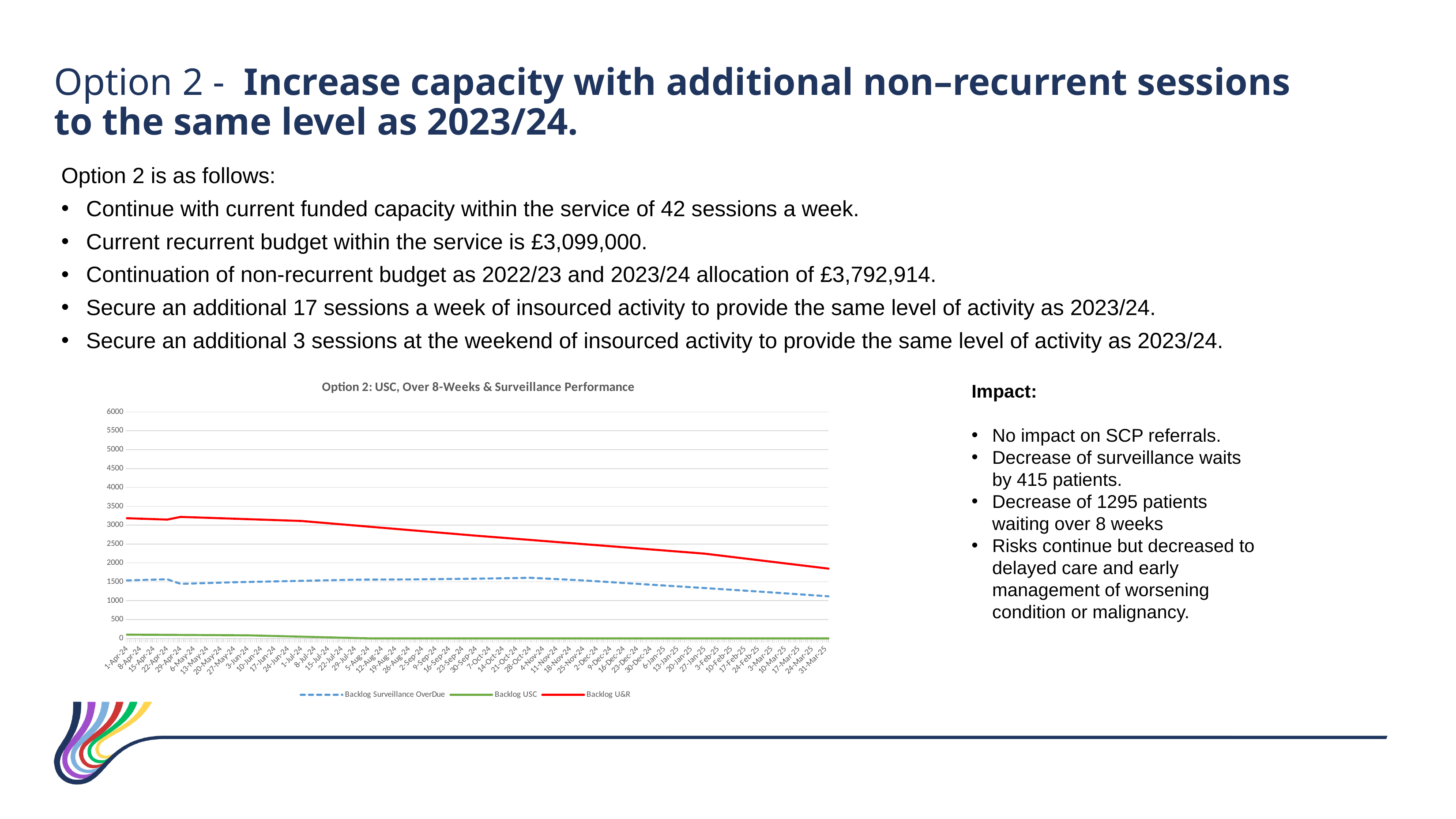
How many series does the chart legend list? 3 What kind of chart is shown on the slide? line chart Does the Backlog U&R line rise or fall from 1-Apr-24 to 31-Mar-25? fall At 31-Mar-25, which is larger: Backlog U&R or Backlog Surveillance OverDue? Backlog U&R Is the value for Backlog U&R at 1-Apr-24 greater or less than 3000? greater What is the title of the chart? Option 2: USC, Over 8-Weeks & Surveillance Performance Which series is drawn as a dashed line in the chart? Backlog Surveillance OverDue Which series has the lowest values throughout the chart? Backlog USC Which series has the highest values throughout the chart? Backlog U&R Is the value for Backlog USC at 1-Apr-24 greater or less than 500? less Is the value for Backlog U&R at 31-Mar-25 greater or less than 2000? less